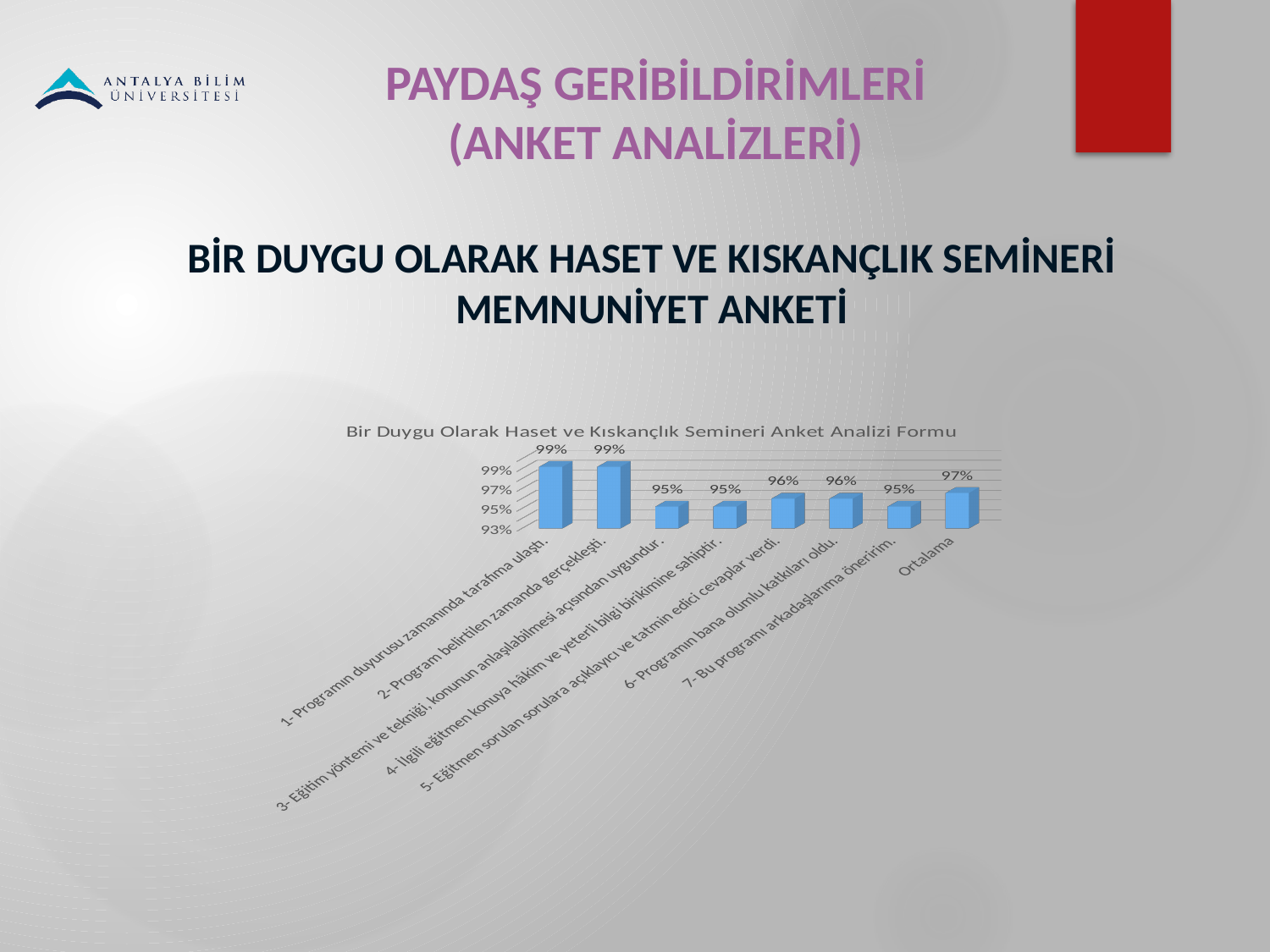
What is the value for '6- Programın bana olumlu katkıları oldu.'? 96% Which is larger: the value for '5- Eğitmen sorulan sorulara açıklayıcı ve tatmin edici cevaplar verdi.' or the value for '7- Bu programı arkadaşlarıma öneririm.'? 5- Eğitmen sorulan sorulara açıklayıcı ve tatmin edici cevaplar verdi. What is the value for '4- İlgili eğitmen konuya hâkim ve yeterli bilgi birikimine sahiptir.'? 95% What is the value for '1- Programın duyurusu zamanında tarafıma ulaştı.'? 99% What kind of chart is shown on the slide? Bar chart What is the title of the chart? Bir Duygu Olarak Haset ve Kıskançlık Semineri Anket Analizi Formu What is the difference between the value for '2- Program belirtilen zamanda gerçekleşti.' and the value for '3- Eğitim yöntemi ve tekniği, konunun anlaşılabilmesi açısından uygundur.'? 4 percentage points What is the value for 'Ortalama' in the chart? 97% What is the value for '7- Bu programı arkadaşlarıma öneririm.'? 95% Is the value for 'Ortalama' greater or less than 95%? greater What is the difference between the value for 'Ortalama' and the value for '6- Programın bana olumlu katkıları oldu.'? 1 percentage point How many categories are shown on the x axis of the chart? 8